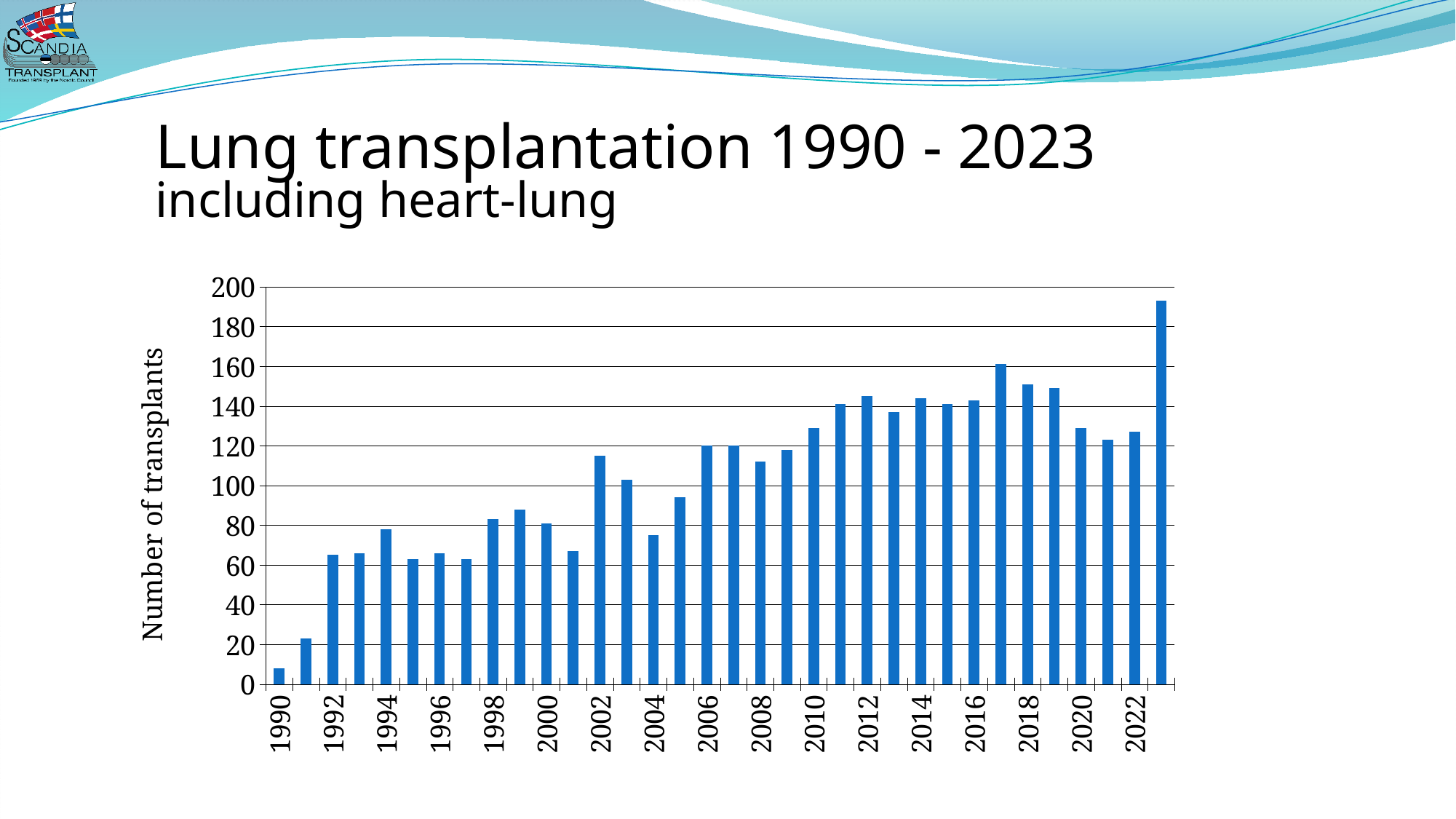
What is the label on the vertical axis of the chart? Number of transplants Is the value for 2017 greater or less than 140? greater Overall, do the number of transplants rise or fall from 1990 to 2023? rise What kind of chart is shown on the slide? bar chart Which year has the lowest number of transplants? 1990 Is the value for 2023 greater or less than 180? greater Is the value for 2002 greater or less than 100? greater Which year has more transplants, 1991 or 1992? 1992 Which year has the highest number of transplants? 2023 Which year has more transplants, 2003 or 2004? 2003